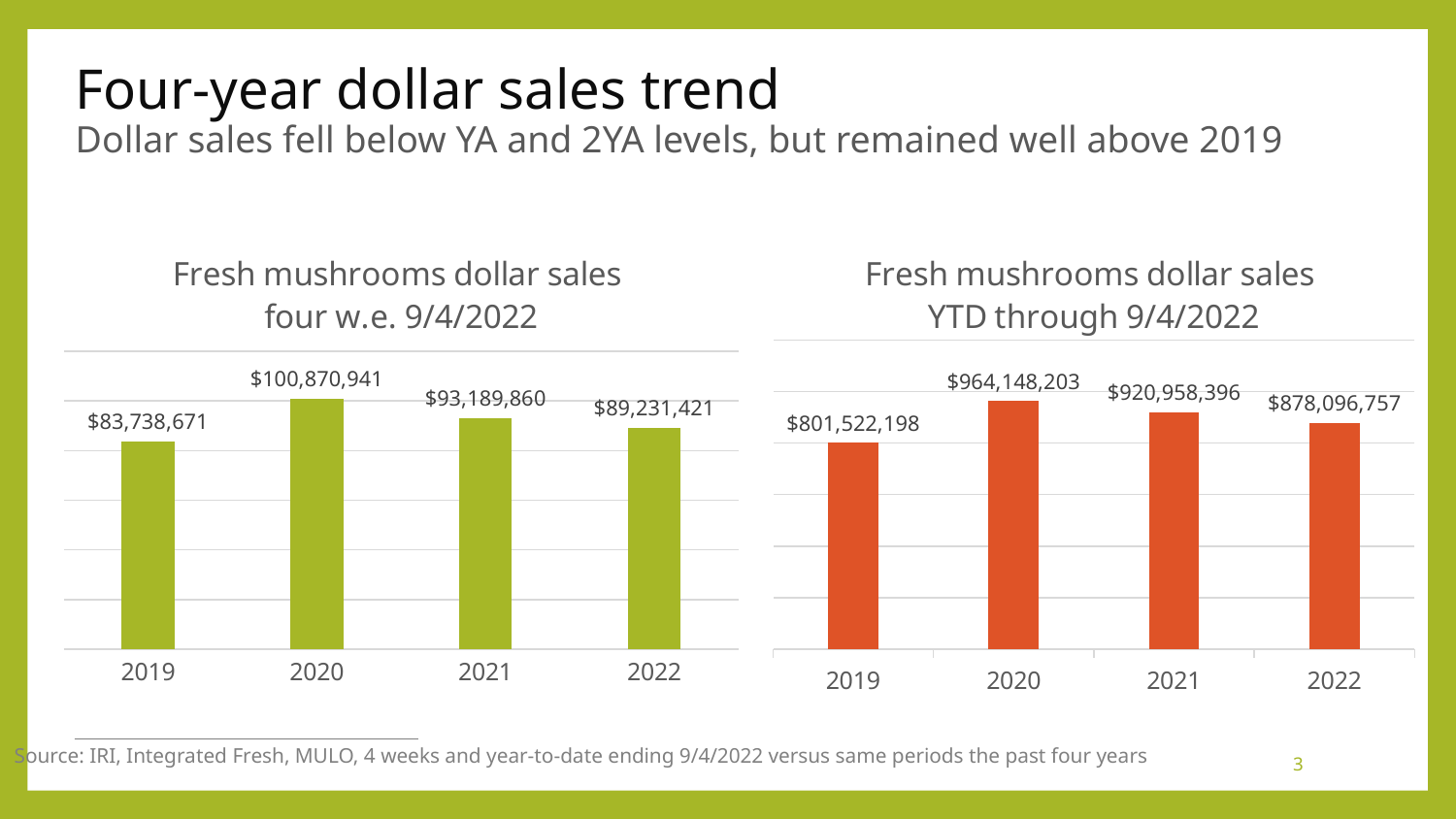
In the 'Fresh mushrooms dollar sales four w.e. 9/4/2022' chart, which year has the lowest value? 2019 In the 'Fresh mushrooms dollar sales four w.e. 9/4/2022' chart, what is the value for 2020? $100,870,941 In the 'Fresh mushrooms dollar sales YTD through 9/4/2022' chart, which is larger, the value for 2019 or the value for 2022? 2022 In the 'Fresh mushrooms dollar sales YTD through 9/4/2022' chart, what is the difference between the 2021 and 2022 values? $42,861,639 In the 'Fresh mushrooms dollar sales four w.e. 9/4/2022' chart, what is the difference between the 2020 and 2019 values? $17,132,270 In the 'Fresh mushrooms dollar sales YTD through 9/4/2022' chart, which year has the highest value? 2020 In the 'Fresh mushrooms dollar sales YTD through 9/4/2022' chart, what is the value for 2022? $878,096,757 What colour are the bars in the 'Fresh mushrooms dollar sales YTD through 9/4/2022' chart? Orange How many years are shown in the 'Fresh mushrooms dollar sales YTD through 9/4/2022' chart? 4 In the 'Fresh mushrooms dollar sales four w.e. 9/4/2022' chart, which is larger, the value for 2021 or the value for 2022? 2021 What kind of chart is the 'Fresh mushrooms dollar sales four w.e. 9/4/2022' chart? Bar chart In the 'Fresh mushrooms dollar sales YTD through 9/4/2022' chart, do the values rise or fall from 2020 to 2022? Fall